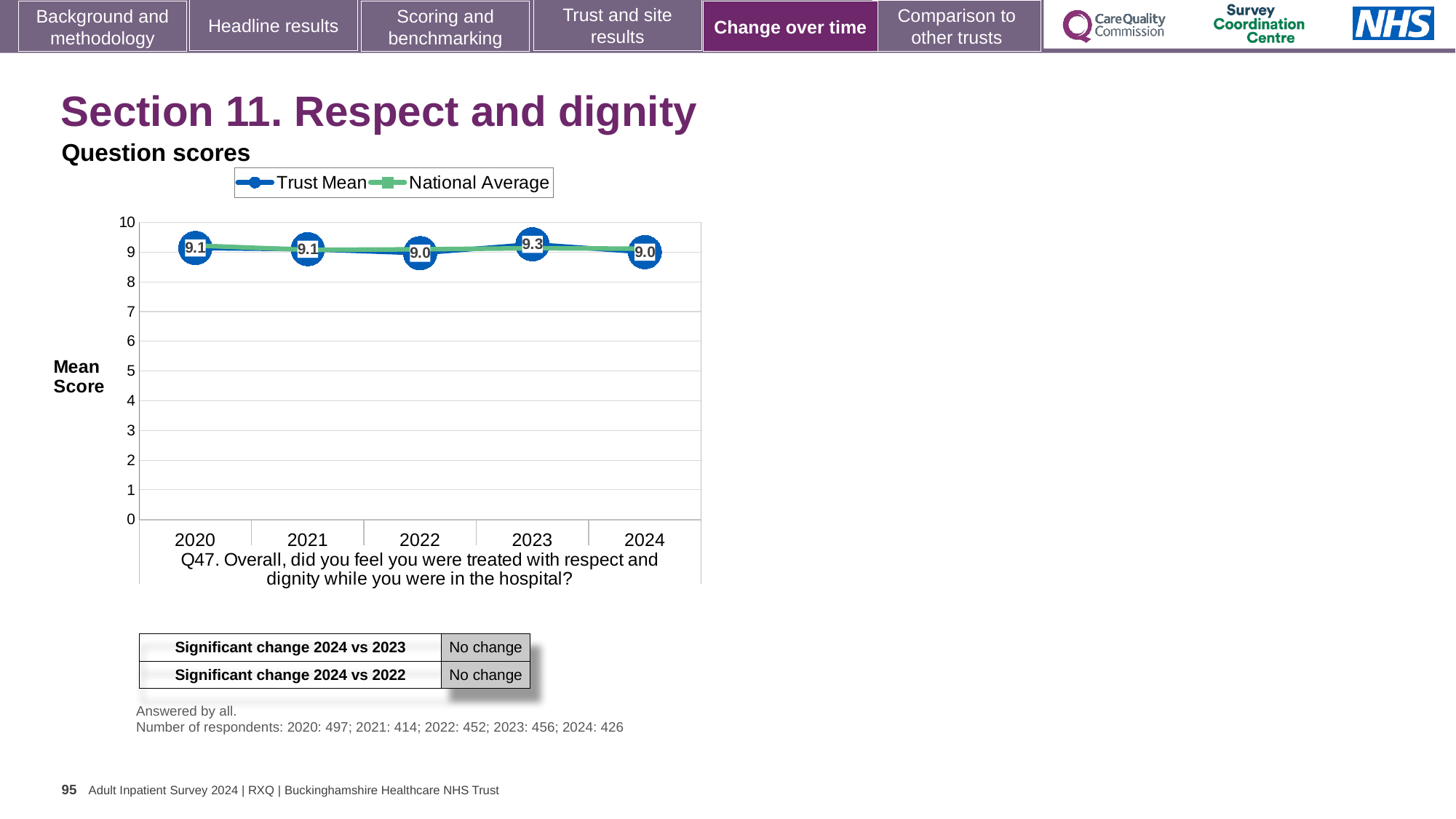
What are the two series named in the legend? Trust Mean and National Average Which year has the larger Trust Mean score, 2022 or 2023? 2023 What is the Trust Mean score for 2024? 9.0 Does the Trust Mean score rise or fall from 2023 to 2024? fall What kind of chart is shown? line chart How many series does the legend list? 2 How many years are plotted on the x axis? 5 In which year is the Trust Mean score highest? 2023 What is the Trust Mean score for 2020? 9.1 Is the National Average value for 2024 greater or less than 5? greater What is the difference between the Trust Mean scores for 2023 and 2024? 0.3 What is the Trust Mean score for 2023? 9.3